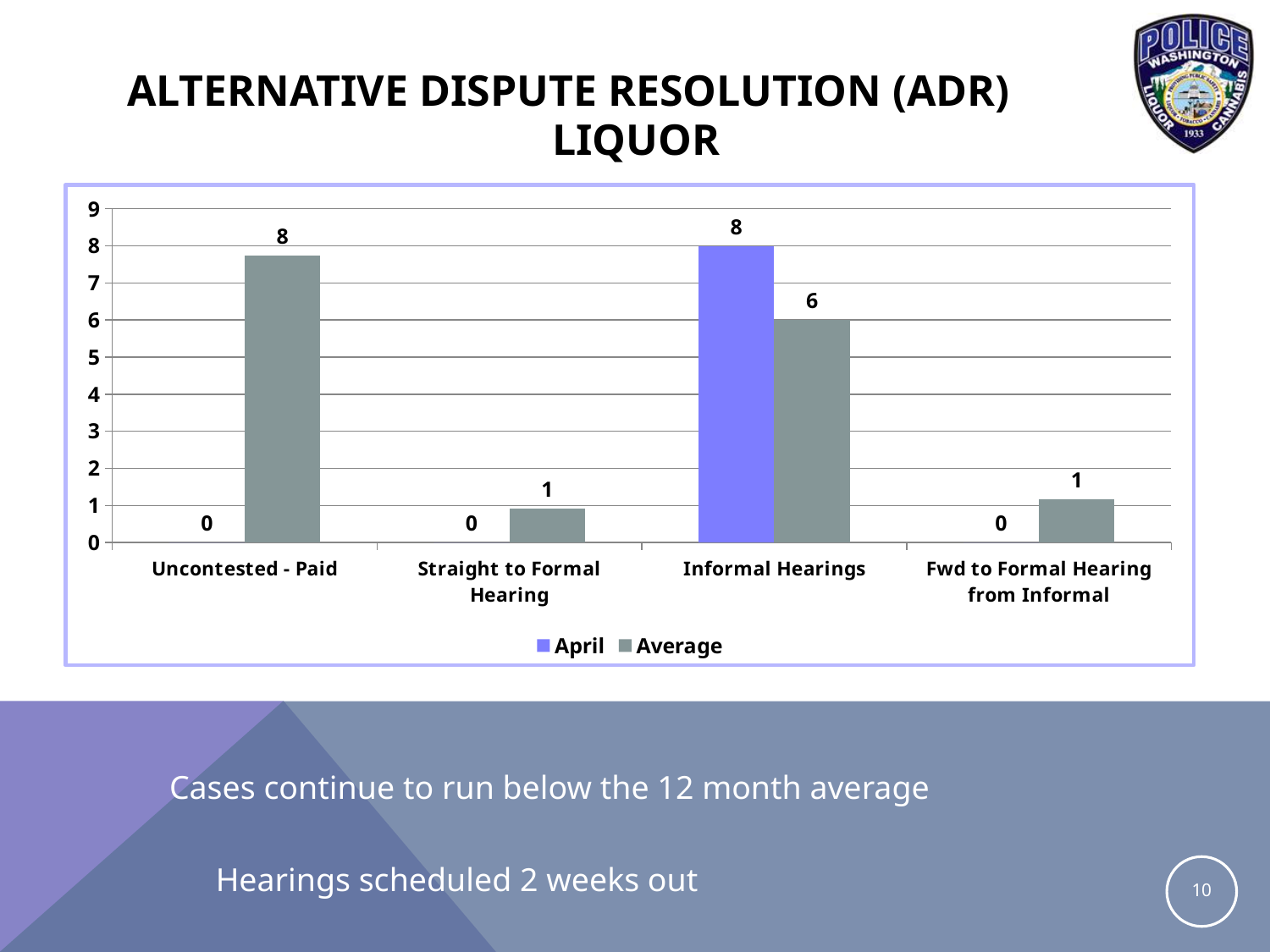
How many categories are shown on the x axis? 4 Which category has the highest April value? Informal Hearings What is the Average value for Straight to Formal Hearing? 1 What are the two series named in the legend? April and Average For Informal Hearings, which is larger, the April value or the Average value? April What is the difference between the April and Average values for Informal Hearings? 2 How many series does the legend list? 2 Which category has the highest Average value? Uncontested - Paid What is the April value for Fwd to Formal Hearing from Informal? 0 What is the April value for Informal Hearings? 8 What type of chart is shown on the slide? bar chart What is the Average value for Uncontested - Paid? 8